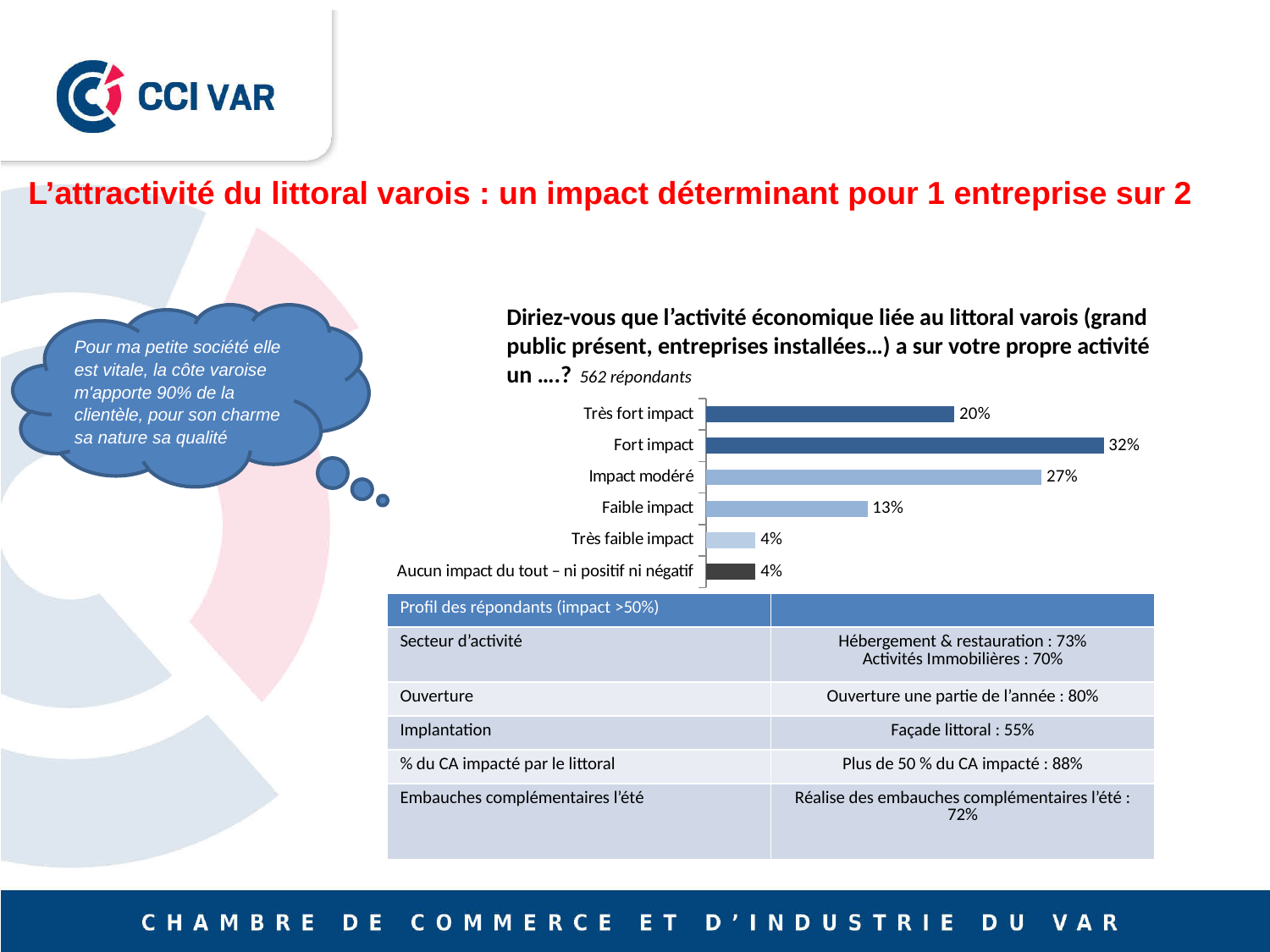
What is the value for "Impact modéré"? 27% What type of chart is shown on the slide? bar chart What is the value for "Très faible impact"? 4% What is the difference between the values for "Fort impact" and "Impact modéré"? 5% What is the value for "Fort impact"? 32% How many respondents does the chart indicate? 562 répondants What is the value for "Très fort impact"? 20% Which is larger, the value for "Impact modéré" or the value for "Très fort impact"? Impact modéré What is the value for "Faible impact"? 13% How many categories are shown in the bar chart? 6 What is the difference between the values for "Très fort impact" and "Faible impact"? 7% Which category has the highest value? Fort impact